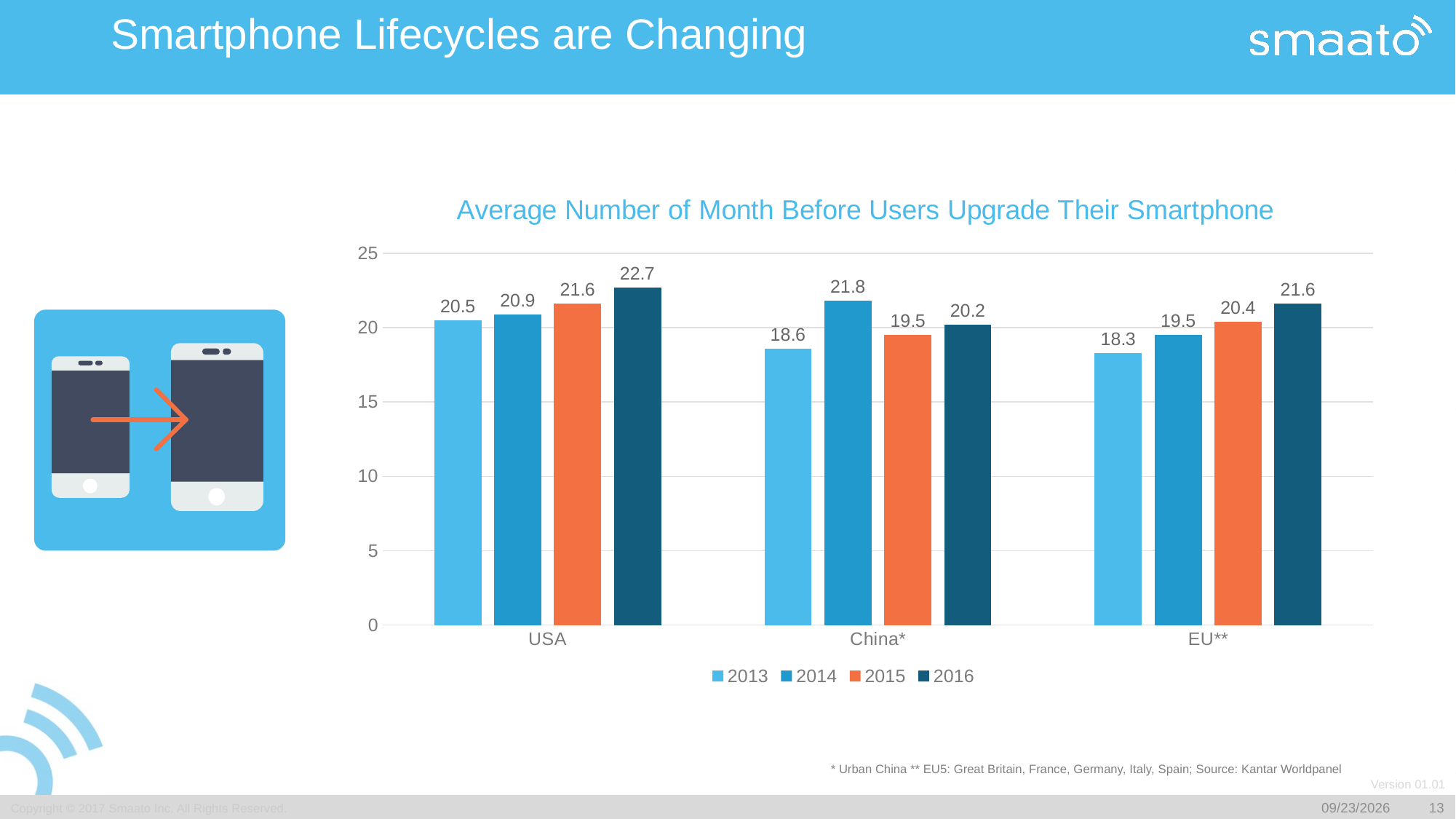
What is the value for China* in 2013? 18.6 How many categories are shown on the x axis? 3 What is the difference between the 2016 and 2013 values for USA? 2.2 What is the value for EU** in 2015? 20.4 What is the title of the chart? Average Number of Month Before Users Upgrade Their Smartphone What kind of chart is shown on the slide? bar chart How many series does the legend list? 4 Is the value for EU** in 2013 greater or less than 20? less Which category has the highest value for the 2016 series? USA Which category has the lowest value for the 2013 series? EU** Which is larger, the 2014 value for China* or the 2014 value for USA? China* What is the value for USA in 2016? 22.7